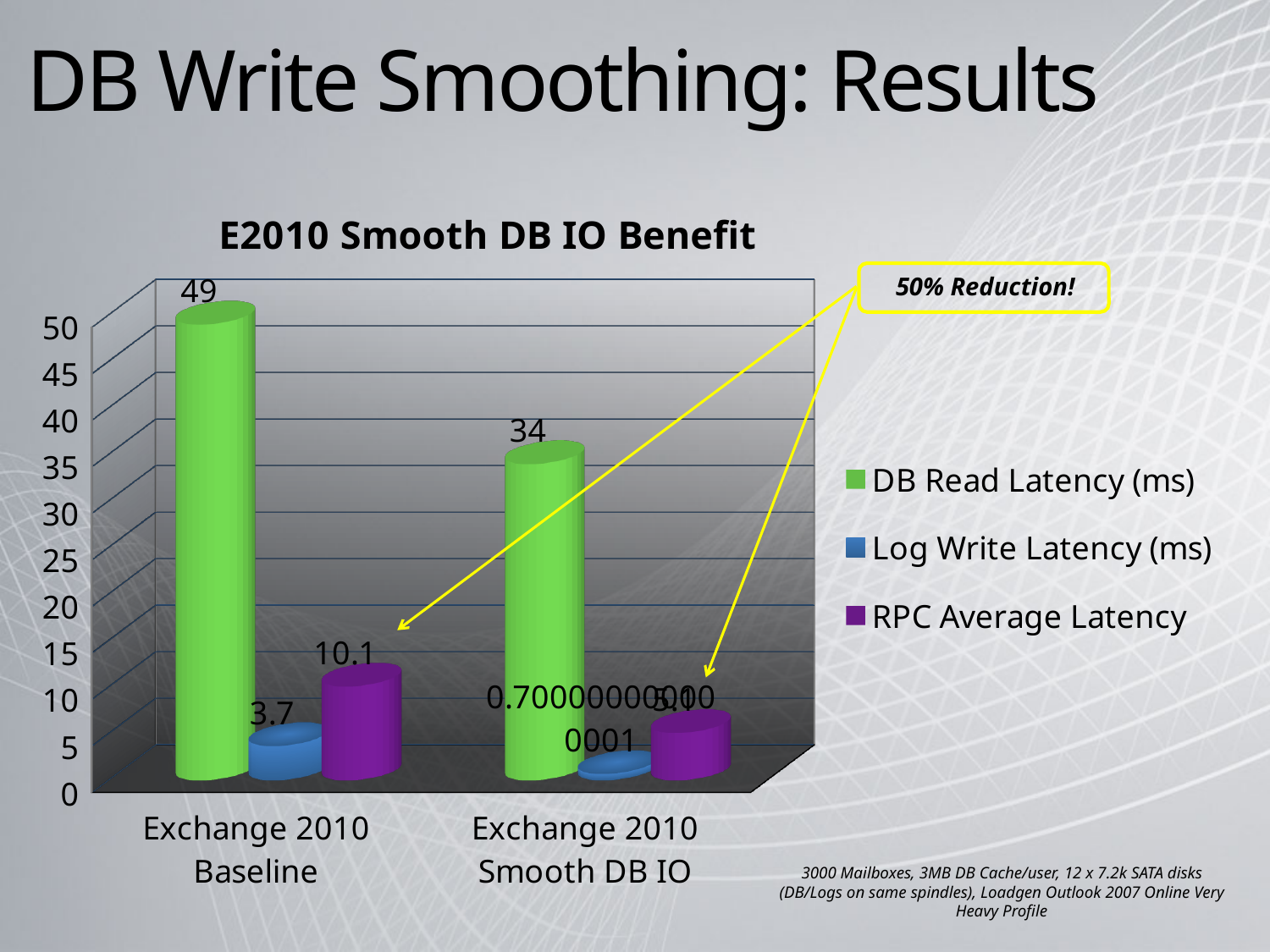
How many categories are shown on the x axis of the chart? 2 What is the RPC Average Latency for Exchange 2010 Baseline? 10.1 What is the Log Write Latency (ms) for Exchange 2010 Baseline? 3.7 Is the RPC Average Latency for Exchange 2010 Smooth DB IO greater or less than 10? less Which series has the lowest value for Exchange 2010 Baseline? Log Write Latency (ms) Which has the higher DB Read Latency (ms): Exchange 2010 Baseline or Exchange 2010 Smooth DB IO? Exchange 2010 Baseline Which series has the highest value for Exchange 2010 Baseline? DB Read Latency (ms) What is the DB Read Latency (ms) for Exchange 2010 Smooth DB IO? 34 What type of chart is shown on the slide? Bar chart What is the DB Read Latency (ms) for Exchange 2010 Baseline? 49 How many series does the chart legend list? 3 By how much does DB Read Latency (ms) drop from Exchange 2010 Baseline to Exchange 2010 Smooth DB IO? 15